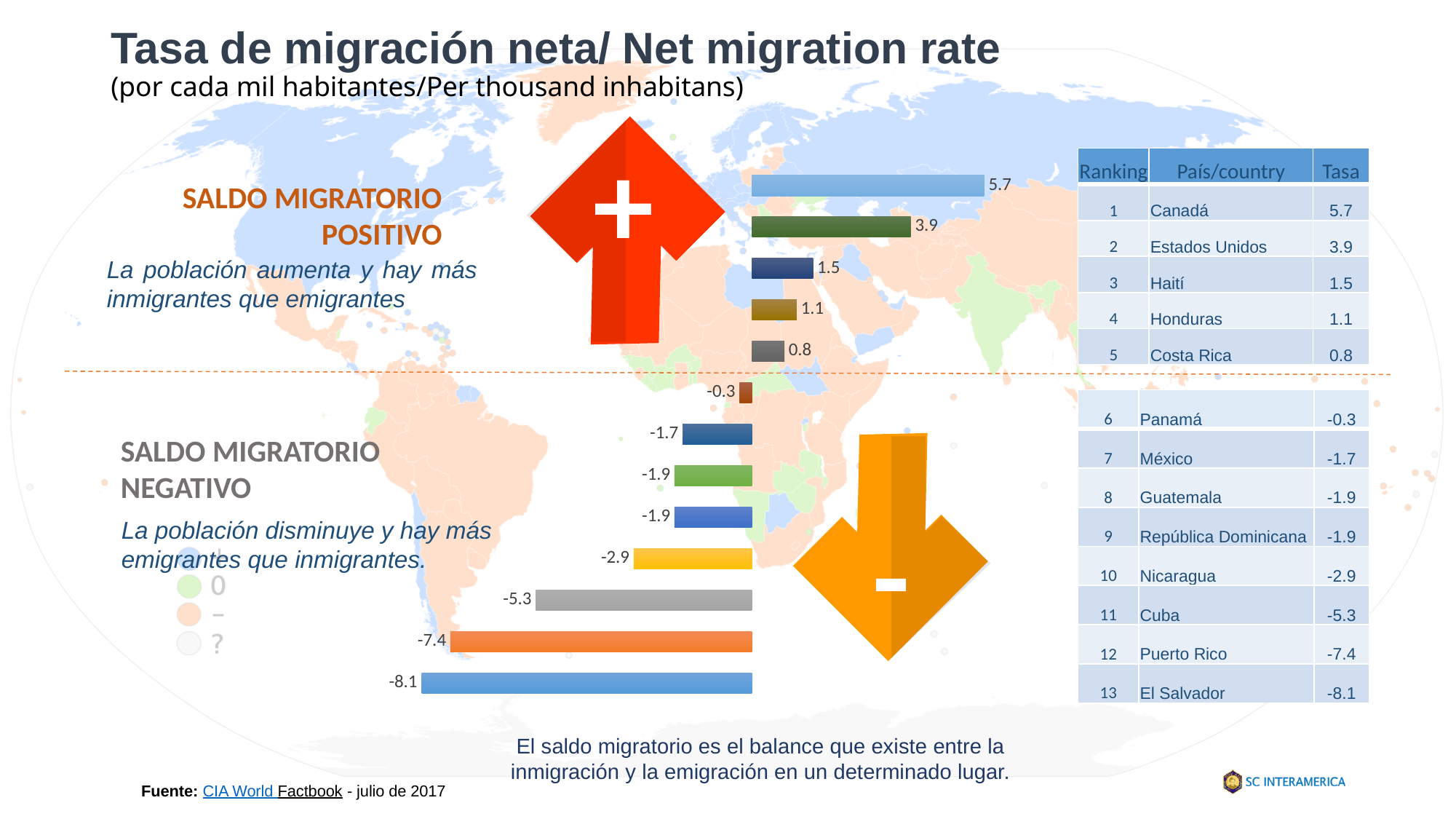
What is the difference between the net migration rates of Canadá and Estados Unidos? 1.8 What is the net migration rate shown for Nicaragua? -2.9 What is the title of the slide containing the chart? Tasa de migración neta/ Net migration rate What is the difference between the net migration rates of Puerto Rico and El Salvador? 0.7 How many countries on the chart have a positive net migration rate? 5 How many bars does the chart contain? 13 What is the net migration rate shown for Canadá? 5.7 Which has a larger net migration rate, Haití or Costa Rica? Haití Which country has the highest net migration rate on the chart? Canadá What is the net migration rate shown for Honduras? 1.1 Which country has the lowest net migration rate on the chart? El Salvador What kind of chart is shown on the slide? bar chart